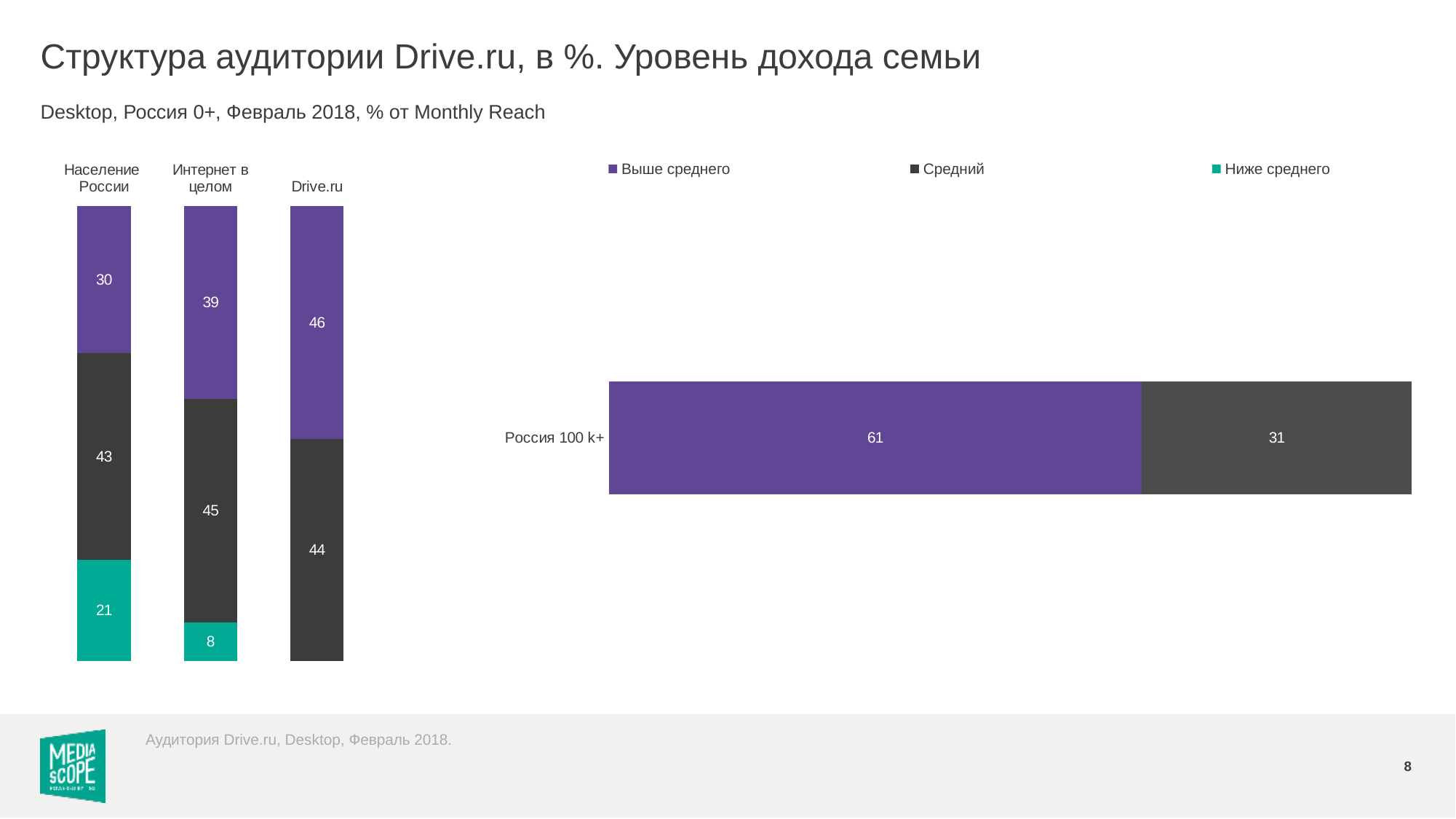
In the right chart, what is the value of Выше среднего for Россия 100 k+? 61 In the right chart, what is the total of the Россия 100 k+ bar? 92 In the left chart, which category has the lowest Средний value? Население России How many series does the legend list? 3 In the left chart, what is the value of Средний for Население России? 43 In the left chart, what is the value of Выше среднего for Drive.ru? 46 In the left chart, which has the larger Средний value: Интернет в целом or Drive.ru? Интернет в целом In the left chart, what is the value of Ниже среднего for Интернет в целом? 8 In the left chart, which category has the highest Выше среднего value? Drive.ru What kind of chart is the right chart? Bar chart How many categories are shown in the left chart? 3 In the left chart, what is the difference between the Выше среднего values for Drive.ru and Население России? 16